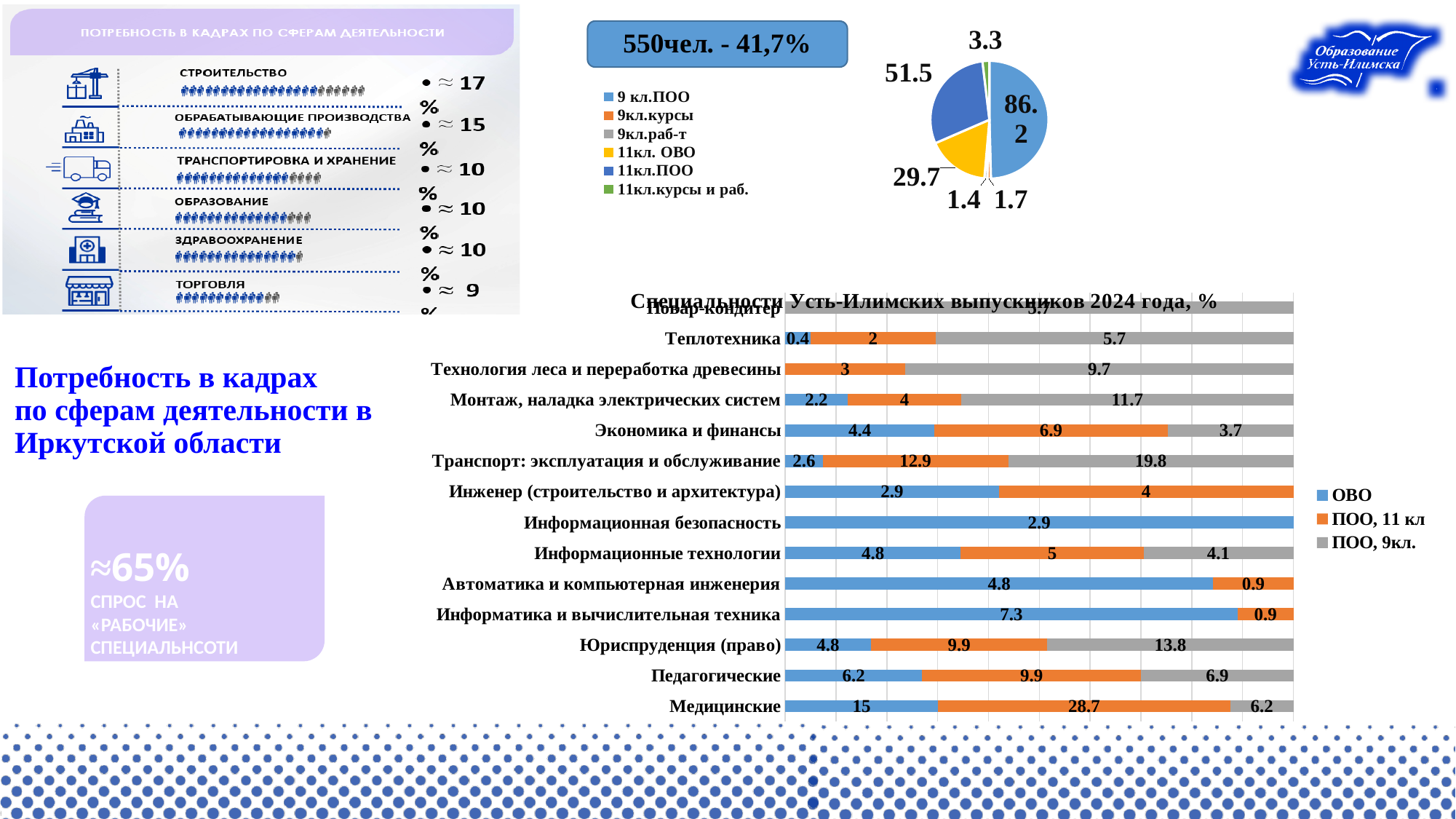
In the chart 'Специальности Усть-Илимских выпускников 2024 года, %', what is the ПОО, 11 кл value for Медицинские? 28.7 What kind of chart is 'Специальности Усть-Илимских выпускников 2024 года, %'? Stacked bar chart In the pie chart at the top of the slide, what value is printed on the 9 кл.ПОО slice? 86.2 In the chart 'Специальности Усть-Илимских выпускников 2024 года, %', how many series does the legend list? 3 In the chart 'Специальности Усть-Илимских выпускников 2024 года, %', what is the ПОО, 9кл. value for Транспорт: эксплуатация и обслуживание? 19.8 In the pie chart at the top of the slide, how many entries does the legend list? 6 In the chart 'Специальности Усть-Илимских выпускников 2024 года, %', what is the total of the stacked bar for Медицинские? 49.9 In the chart 'Специальности Усть-Илимских выпускников 2024 года, %', which is larger: the ОВО value for Медицинские or the ОВО value for Информатика и вычислительная техника? Медицинские In the chart 'Специальности Усть-Илимских выпускников 2024 года, %', how many specialties (categories) are shown? 14 In the chart 'Специальности Усть-Илимских выпускников 2024 года, %', what is the ОВО value for Педагогические? 6.2 In the chart 'Специальности Усть-Илимских выпускников 2024 года, %', what is the difference between the ПОО, 9кл. values for Юриспруденция (право) and Педагогические? 6.9 In the chart 'Специальности Усть-Илимских выпускников 2024 года, %', what is the total of the stacked bar for Юриспруденция (право)? 28.5